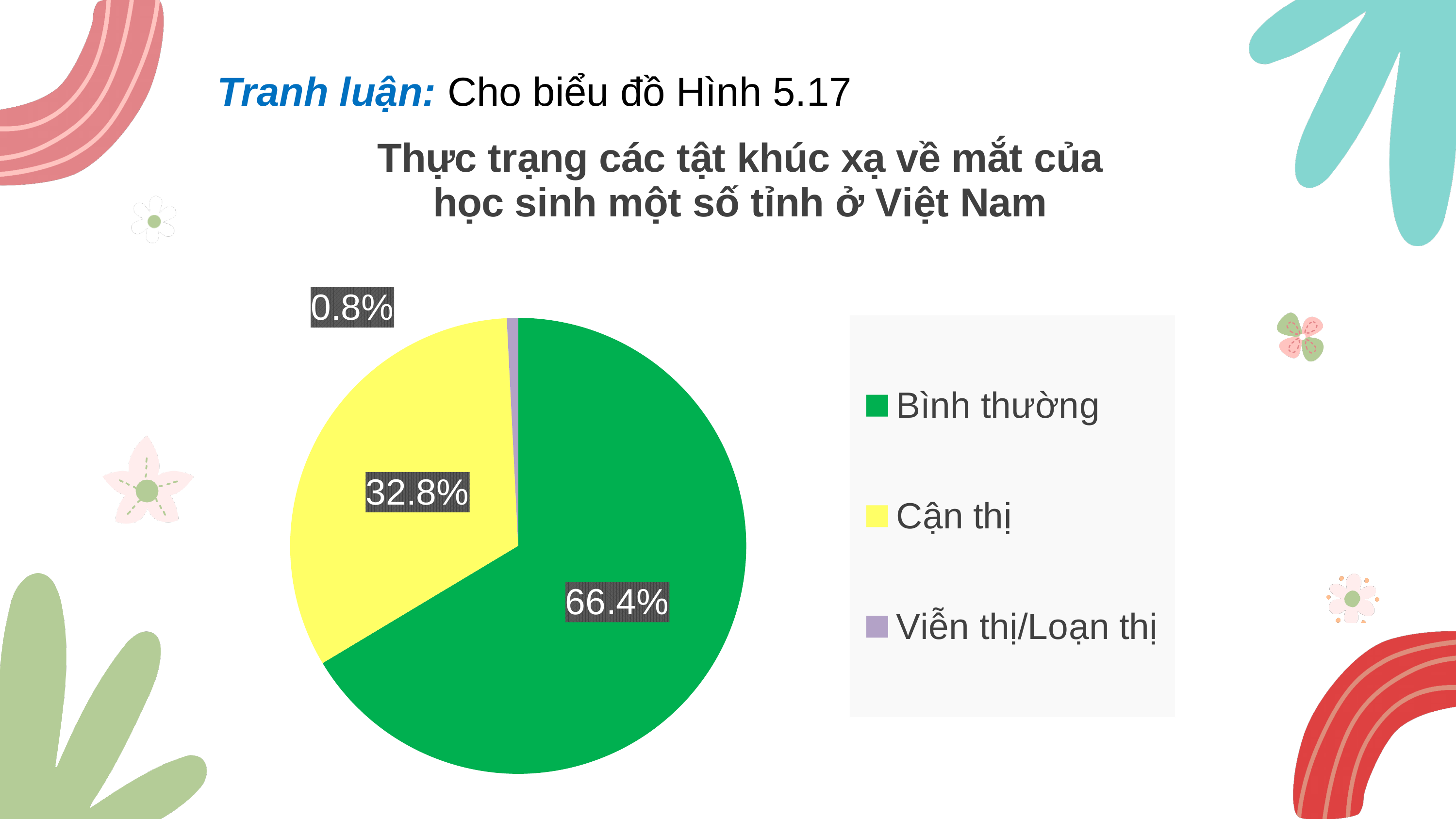
What is the title of the chart? Thực trạng các tật khúc xạ về mắt của học sinh một số tỉnh ở Việt Nam How many entries does the legend list? 3 What is the difference between the Bình thường and Cận thị percentages? 33.6% What share of the pie does Bình thường represent? 66.4% Which is larger, the share for Cận thị or the share for Viễn thị/Loạn thị? Cận thị What colour is the slice for Cận thị? Yellow How many categories are shown in the pie chart? 3 What kind of chart is shown on the slide? Pie chart What is the value shown for Viễn thị/Loạn thị? 0.8% Which category has the largest slice of the pie? Bình thường What is the value shown for Cận thị? 32.8% Which category has the smallest slice of the pie? Viễn thị/Loạn thị